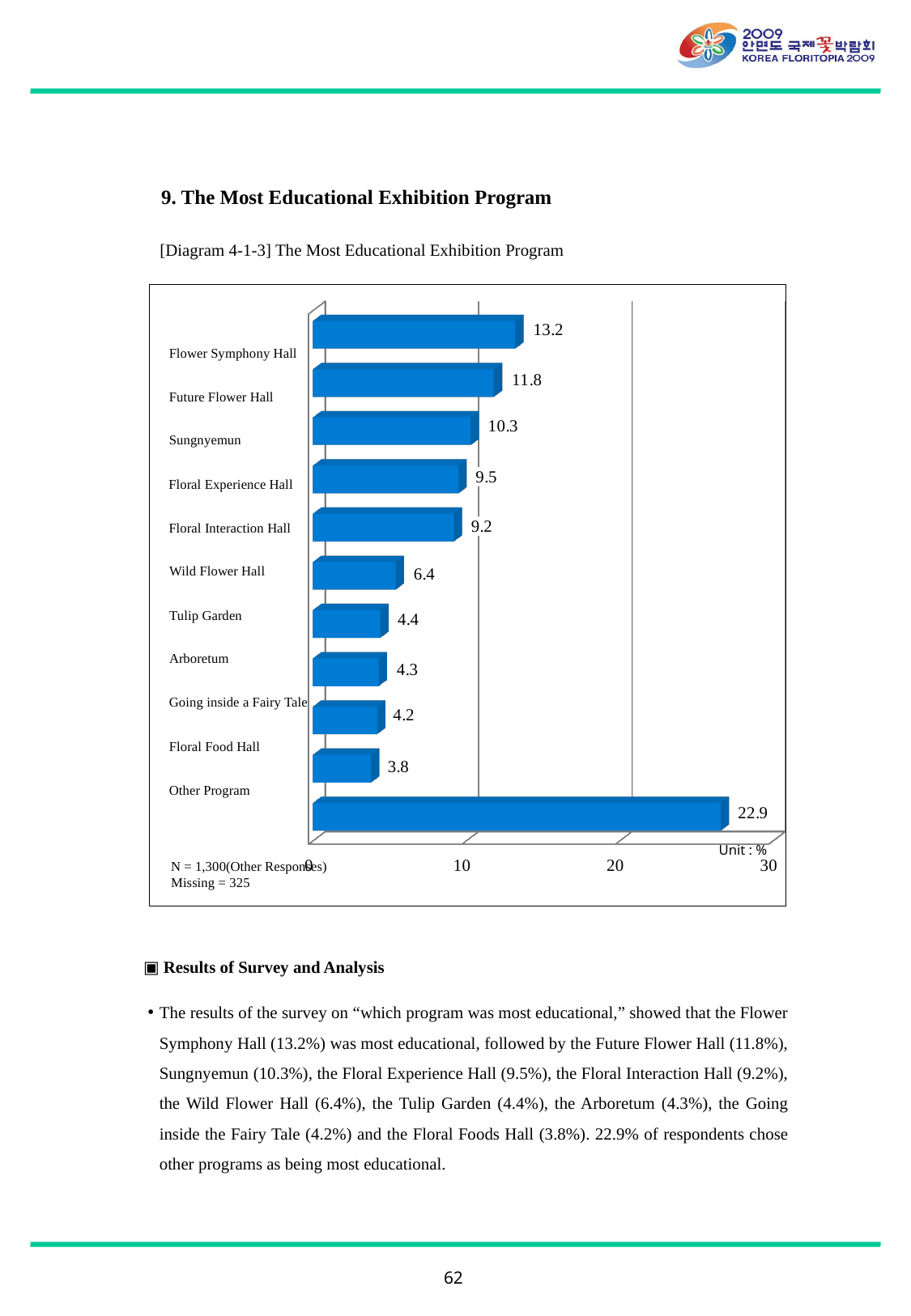
How many categories are shown in the chart? 11 What is the value for Flower Symphony Hall? 13.2 What is the value for Other Program? 22.9 What unit is indicated for the values in the chart? % Which category has the highest value? Other Program What is the value for Wild Flower Hall? 6.4 Is the value for Other Program greater or less than 20? greater Which category has the lowest value? Floral Food Hall What is the value for Sungnyemun? 10.3 What is the difference between the values for Flower Symphony Hall and Future Flower Hall? 1.4 What type of chart is shown in Diagram 4-1-3? bar chart Which is larger, the value for Floral Experience Hall or Floral Interaction Hall? Floral Experience Hall